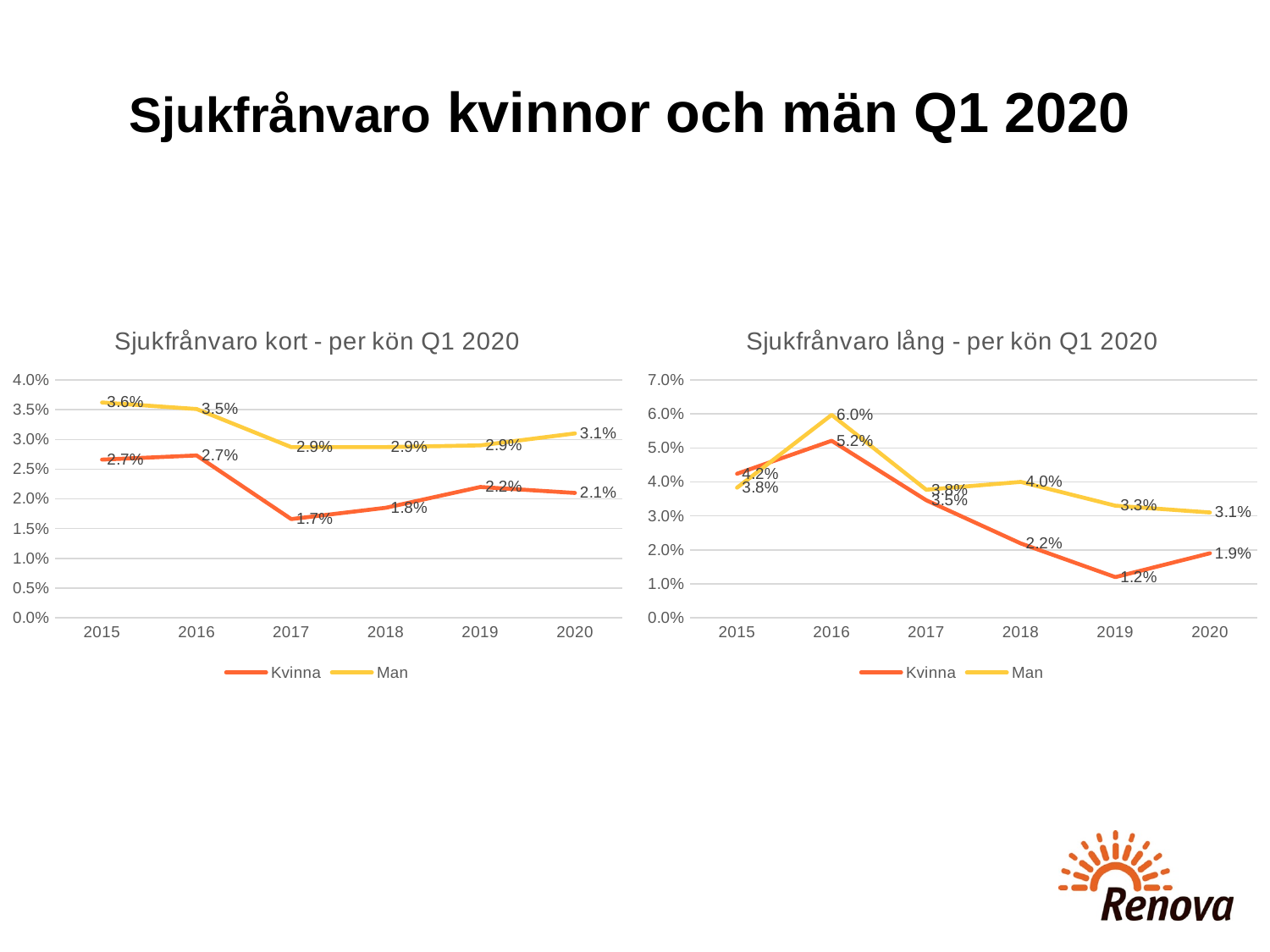
How many years are shown on the x axis of the chart titled "Sjukfrånvaro lång - per kön Q1 2020"? 6 In the chart titled "Sjukfrånvaro kort - per kön Q1 2020", how many series does the legend list? 2 In the chart titled "Sjukfrånvaro lång - per kön Q1 2020", what is the difference between the Man and Kvinna values in 2018? 1.8% In the chart titled "Sjukfrånvaro kort - per kön Q1 2020", what is the difference between the Man and Kvinna values in 2020? 1.0% In the chart titled "Sjukfrånvaro kort - per kön Q1 2020", what is the value for Kvinna in 2017? 1.7% In the chart titled "Sjukfrånvaro lång - per kön Q1 2020", in which year is the Kvinna value highest? 2016 In the chart titled "Sjukfrånvaro lång - per kön Q1 2020", what is the value for Kvinna in 2019? 1.2% In the chart titled "Sjukfrånvaro lång - per kön Q1 2020", what is the value for Man in 2016? 6.0% In the chart titled "Sjukfrånvaro kort - per kön Q1 2020", what is the value for Man in 2015? 3.6% In the chart titled "Sjukfrånvaro lång - per kön Q1 2020", which is larger in 2015, the Kvinna value or the Man value? Kvinna In the chart titled "Sjukfrånvaro kort - per kön Q1 2020", in which year is the Kvinna value lowest? 2017 What kind of chart is the chart titled "Sjukfrånvaro kort - per kön Q1 2020"? Line chart